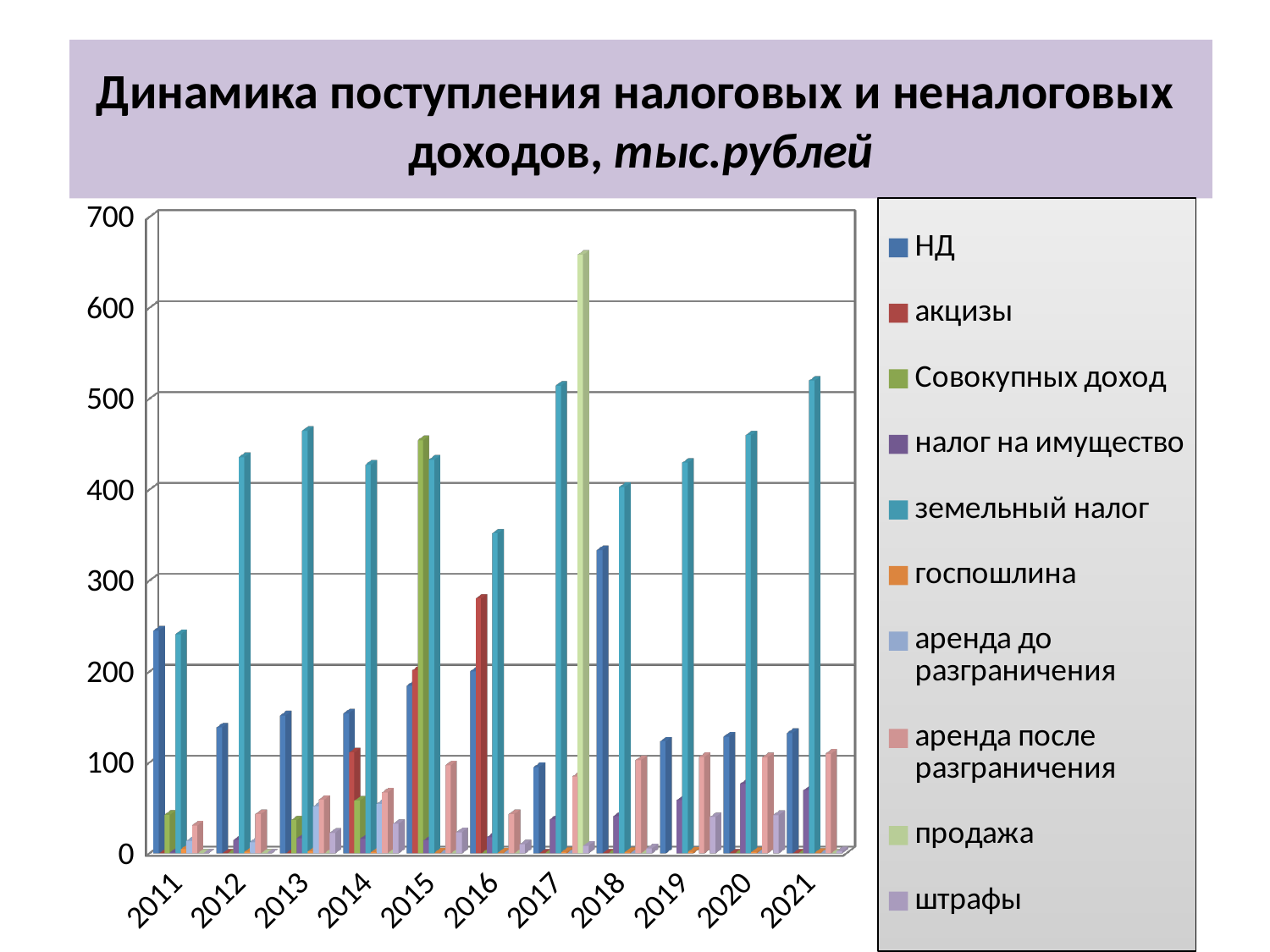
In which year is the value for земельный налог lowest? 2011 Which is larger: НД in 2011 or НД in 2012? НД in 2011 Is the value for НД in 2018 greater or less than 300? greater How many series does the legend list? 10 Which is larger: акцизы in 2016 or акцизы in 2014? акцизы in 2016 Is the value for продажа in 2017 greater or less than 600? greater Which series has the tallest bar in 2017? продажа How many years are shown on the x axis? 11 What kind of chart is shown on the slide? bar chart Is the value for Совокупных доход in 2015 greater or less than 400? greater What unit is stated in the chart title? тыс.рублей